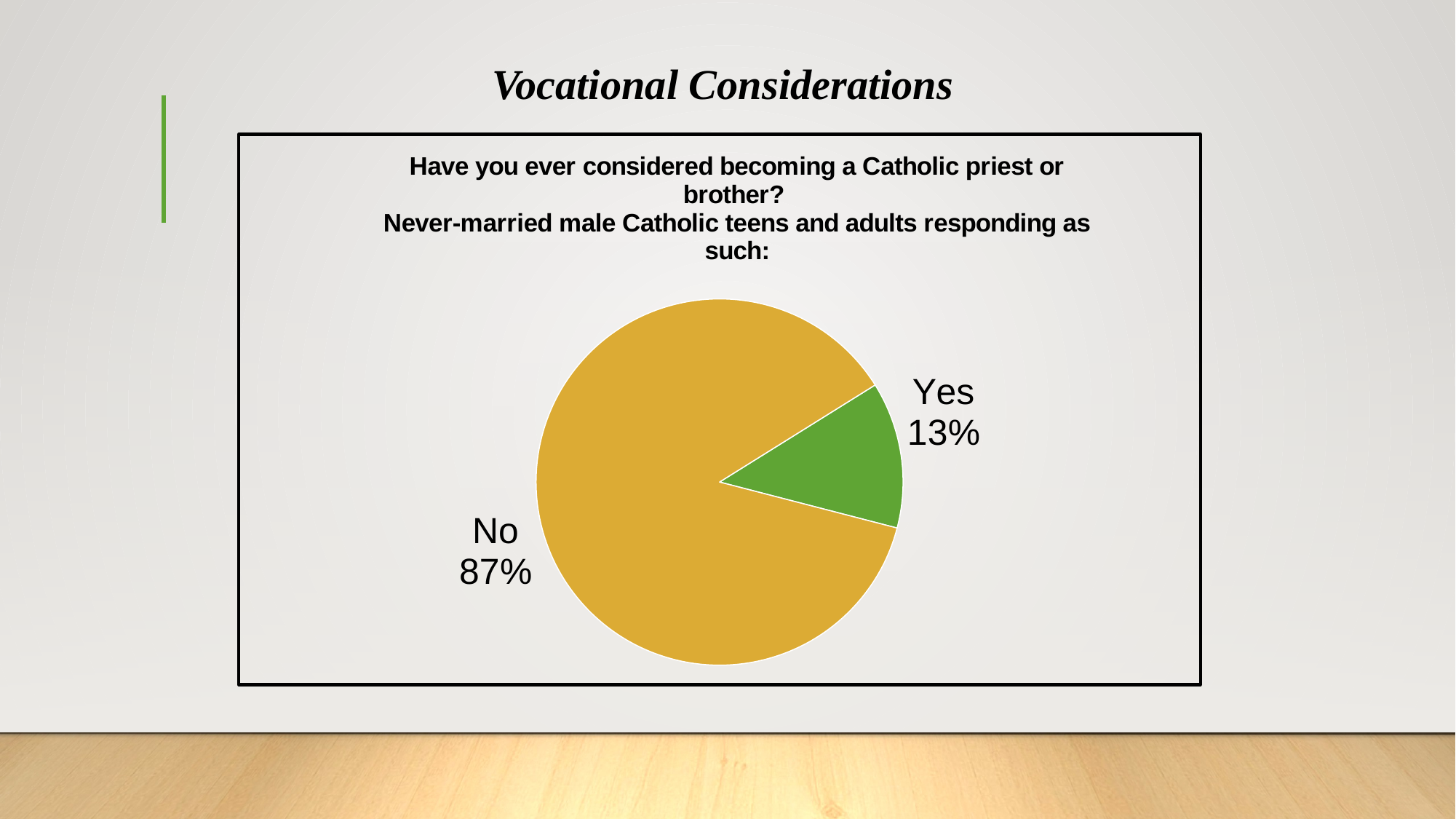
What percentage of respondents answered "No"? 87% What is the difference in percentage points between the "No" and "Yes" slices? 74 Which response has the smallest share of the pie? Yes What percentage of respondents answered "Yes"? 13% What share of the pie does the "Yes" slice represent? 13% What question does the chart title say respondents were asked? Have you ever considered becoming a Catholic priest or brother? What kind of chart is shown on the slide? pie chart What colour is the "Yes" slice? green Which response has the largest share of the pie? No How many slices does the pie chart have? 2 Which slice is larger, "Yes" or "No"? No